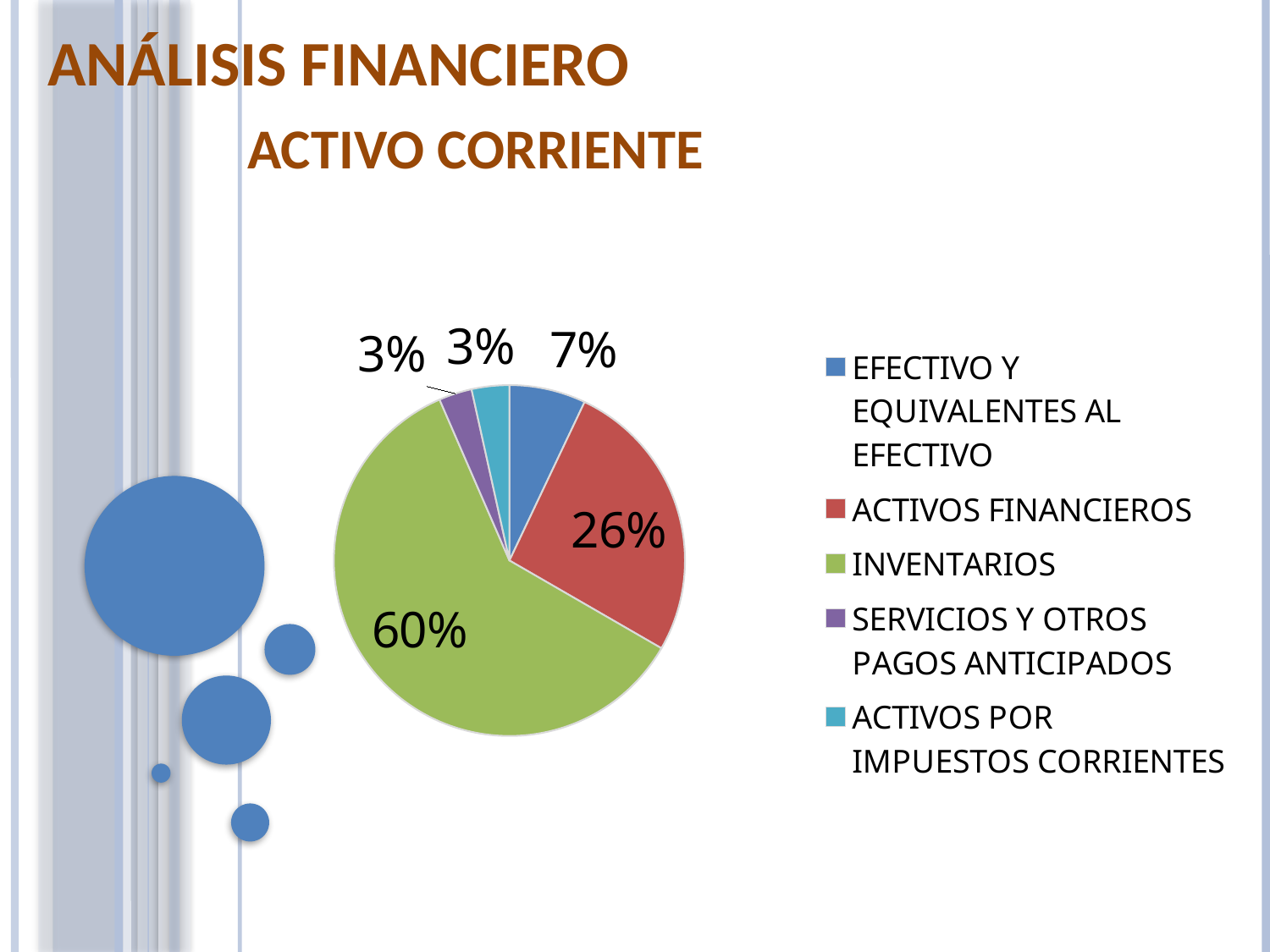
Which category has the largest slice of the pie? INVENTARIOS What share of the pie does ACTIVOS FINANCIEROS represent? 26% What share of the pie does EFECTIVO Y EQUIVALENTES AL EFECTIVO represent? 7% How many slices does the pie chart have? 5 What is the difference in percentage points between INVENTARIOS and ACTIVOS FINANCIEROS? 34 What share of the pie does INVENTARIOS represent? 60% How many entries does the legend list? 5 What kind of chart is shown on the slide? pie chart Which is larger, the slice for ACTIVOS FINANCIEROS or the slice for EFECTIVO Y EQUIVALENTES AL EFECTIVO? ACTIVOS FINANCIEROS What colour is the slice for INVENTARIOS? green